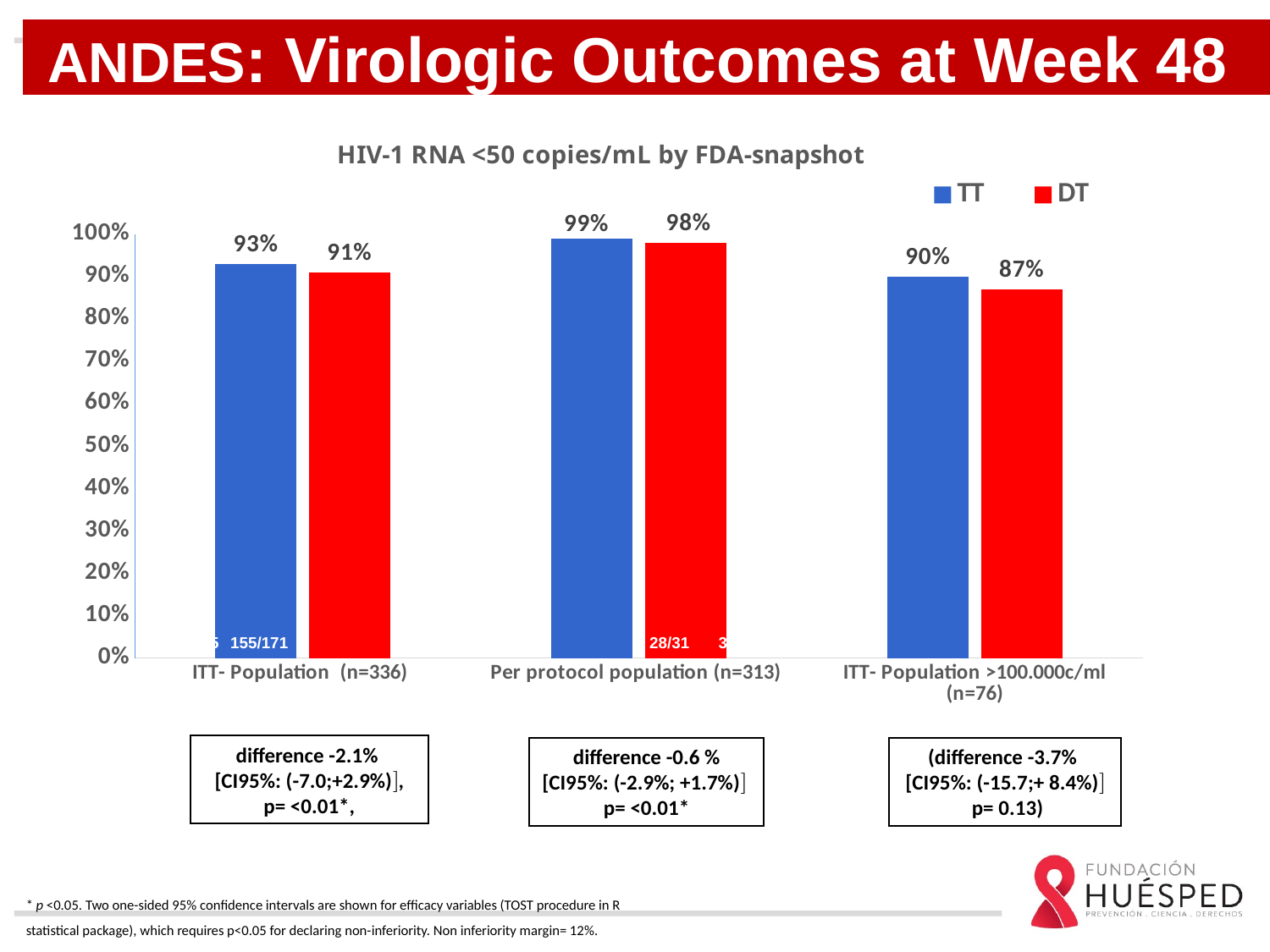
What is the value for DT in the ITT- Population >100.000c/ml (n=76) category? 87% What is the value for TT in the ITT- Population >100.000c/ml (n=76) category? 90% What is the difference between the TT and DT values in the ITT- Population >100.000c/ml (n=76) category? 3% How many categories are shown on the x axis? 3 What is the value for DT in the Per protocol population (n=313) category? 98% In which category does the DT series have its lowest value? ITT- Population >100.000c/ml (n=76) Which is larger in the ITT- Population (n=336) category, the TT value or the DT value? TT How many series does the legend list? 2 What is the value for TT in the ITT- Population (n=336) category? 93% In which category does the TT series reach its highest value? Per protocol population (n=313) What kind of chart is shown on the slide? Bar chart What is the title of the chart? HIV-1 RNA <50 copies/mL by FDA-snapshot